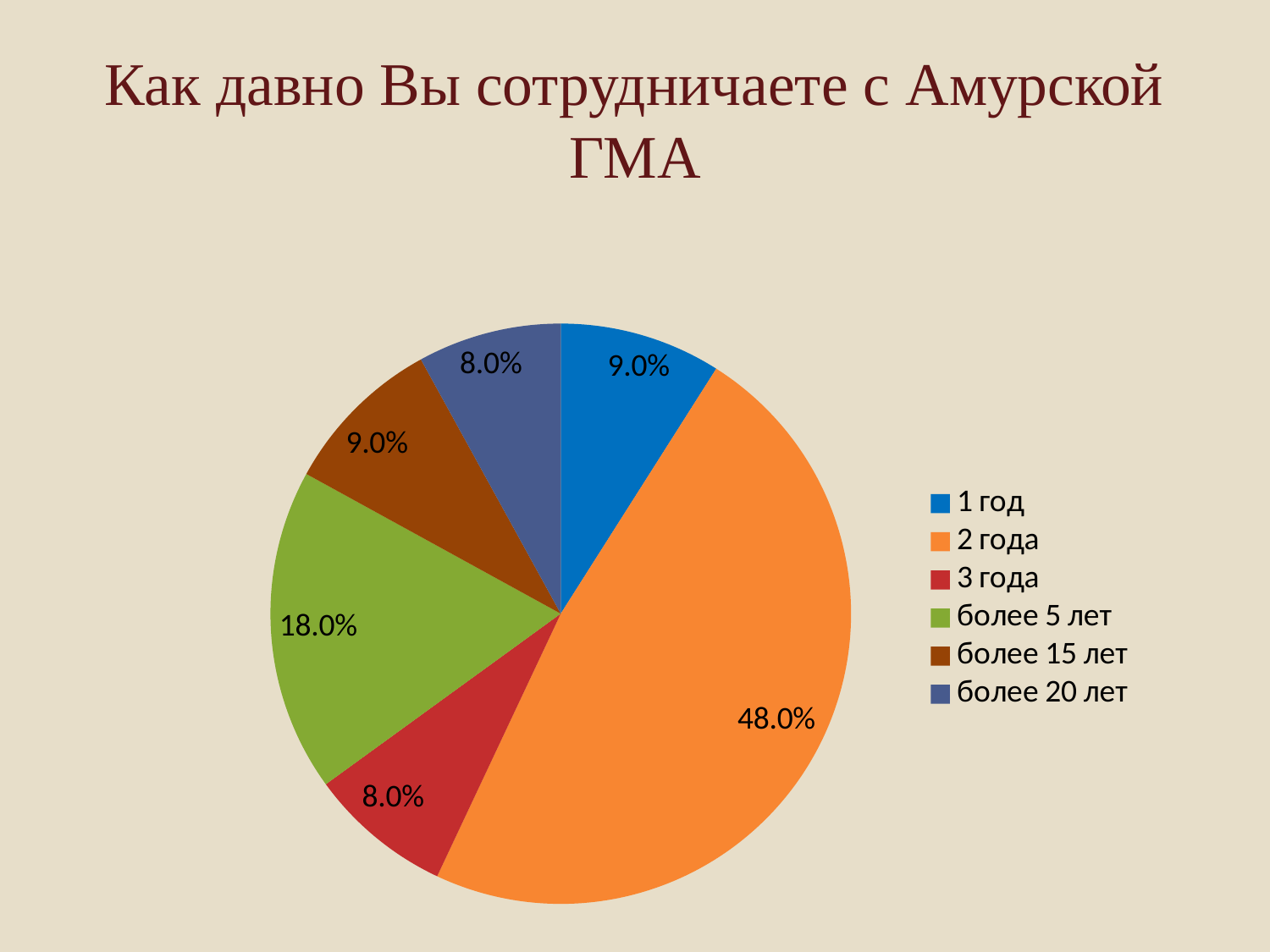
Which is larger, the value for "более 5 лет" or the value for "1 год"? более 5 лет What is the value shown for "3 года"? 8.0% What share of the pie does the "2 года" slice represent? 48.0% What is the value shown for "1 год"? 9.0% What is the title of the chart on the slide? Как давно Вы сотрудничаете с Амурской ГМА What is the value shown for "более 15 лет"? 9.0% What kind of chart is shown on the slide? Pie chart What is the value shown for "более 20 лет"? 8.0% How many categories does the pie chart show? 6 What is the value shown for "более 5 лет"? 18.0% Which category has the largest slice of the pie? 2 года What is the difference between the values for "2 года" and "более 5 лет"? 30.0%